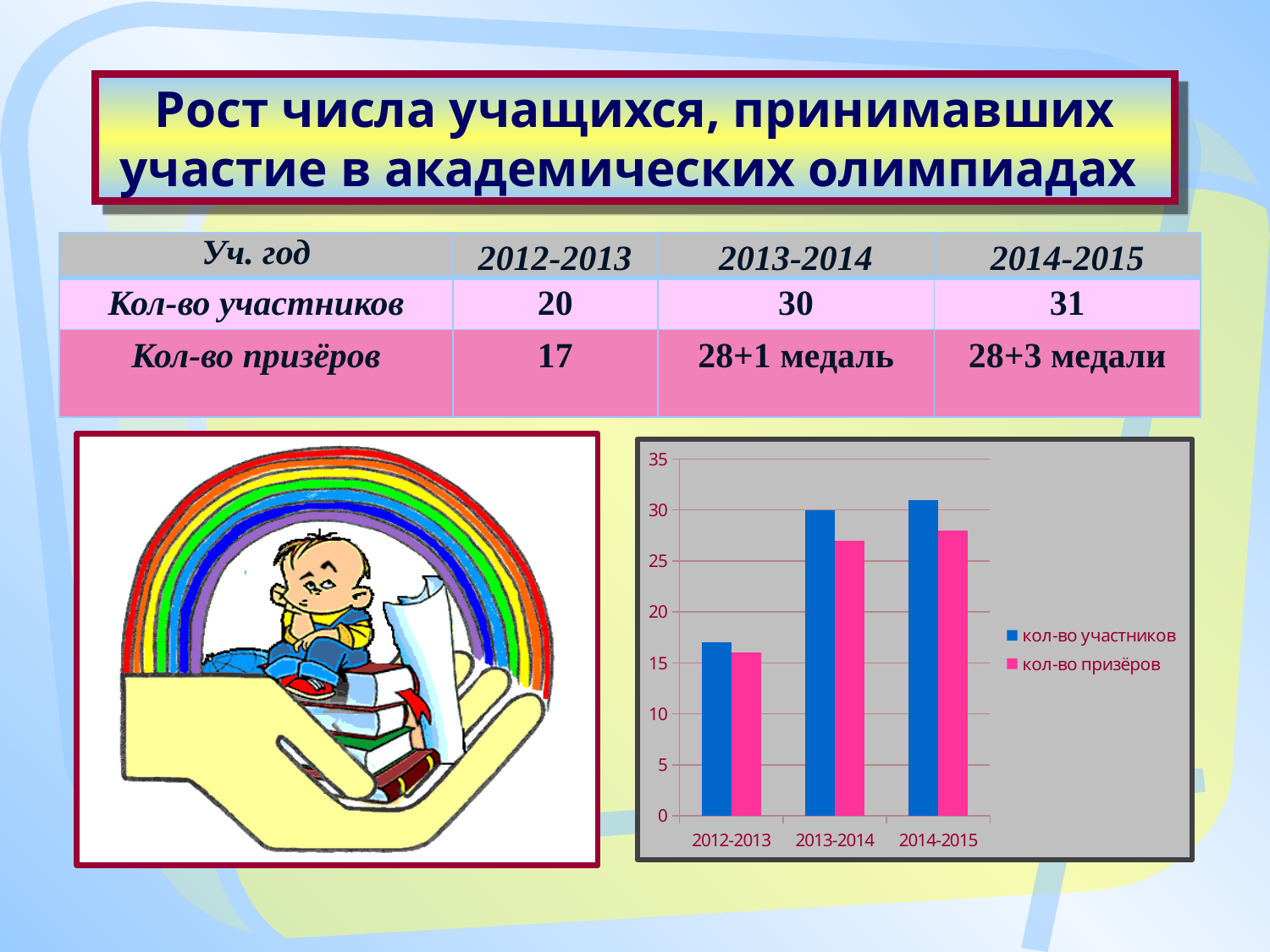
In the chart, which is larger for 2013-2014: кол-во участников or кол-во призёров? кол-во участников What colour are the bars for кол-во призёров in the chart? pink What is the first entry listed in the chart's legend? кол-во участников In the chart, is the value for кол-во участников in 2012-2013 greater or less than 20? less How many academic-year categories are shown on the chart's x axis? 3 What kind of chart is shown on the slide? bar chart In the chart, is the value for кол-во призёров in 2013-2014 greater or less than 25? greater How many series does the chart legend list? 2 Which academic year has the lowest value for кол-во призёров in the chart? 2012-2013 Which academic year has the highest value for кол-во участников in the chart? 2014-2015 Do the values for кол-во участников rise or fall across the years on the chart's x axis? rise